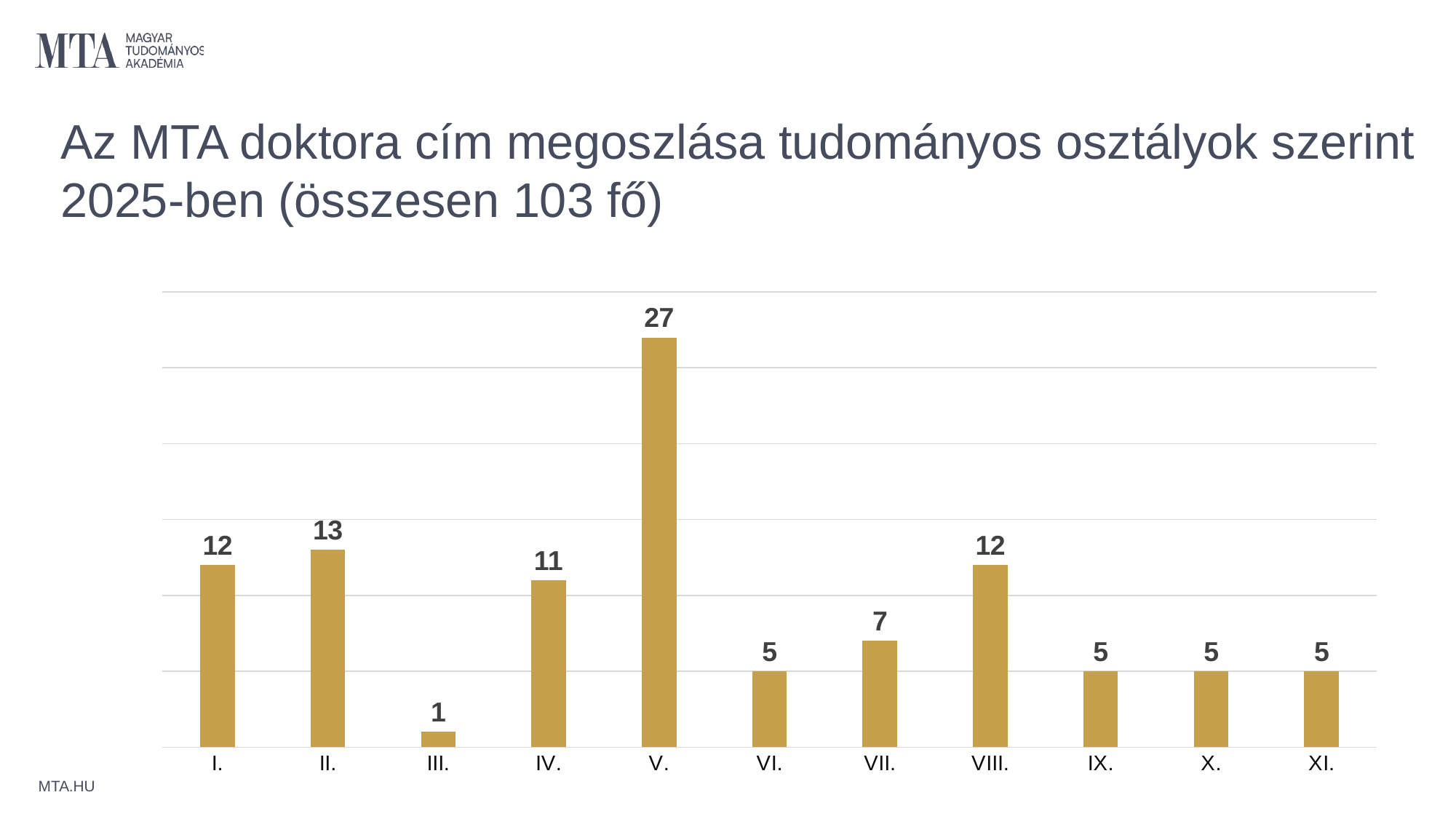
Which is larger, the value for II. or the value for IV.? II. Which category has the lowest value? III. What is the value for category VIII.? 12 What is the value for category V.? 27 How many categories have a value of 5? 4 How many categories are shown on the x axis? 11 Which category has the highest value? V. What is the difference between the values for VII. and VI.? 2 What kind of chart is shown on the slide? bar chart What total number of people does the chart title say the distribution covers? 103 fő What is the difference between the values for V. and II.? 14 What is the value for category III.? 1